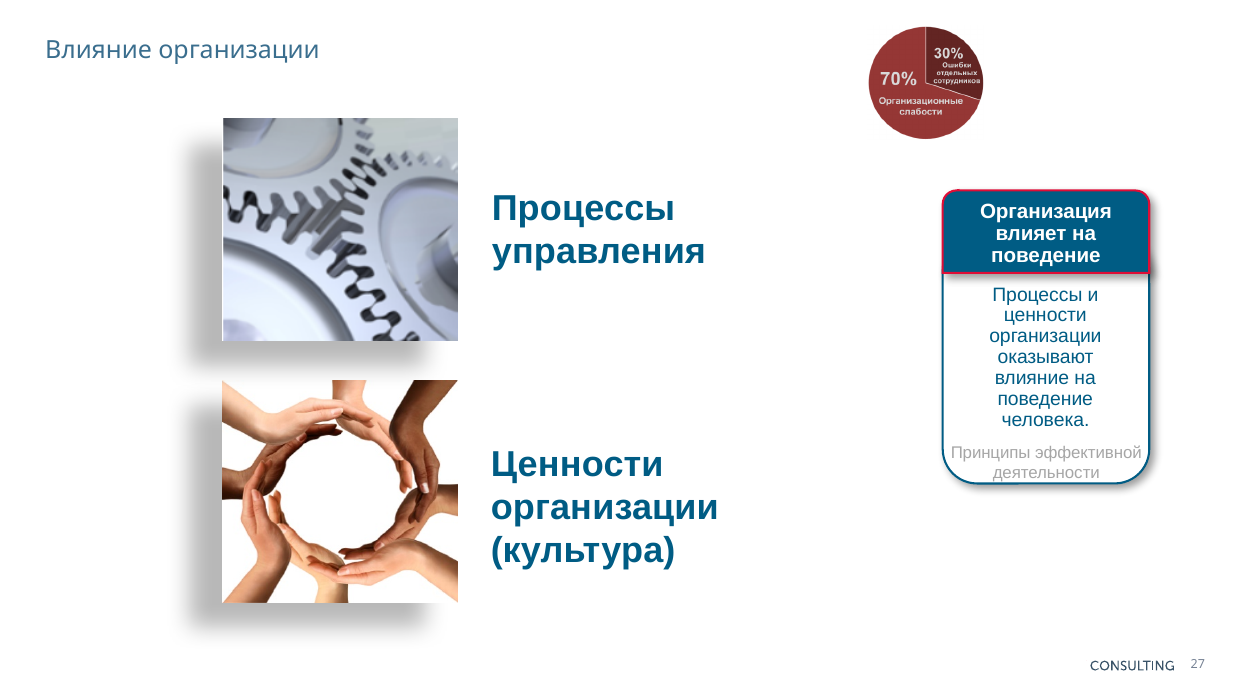
In the pie chart, what share is labelled "Ошибки отдельных сотрудников"? 30% What is the title of the slide containing the pie chart? Влияние организации What is the difference in percentage points between the "Организационные слабости" slice and the "Ошибки отдельных сотрудников" slice? 40 How many slices does the pie chart have? 2 What kind of chart is shown in the top right corner of the slide? Pie chart Which slice of the pie chart is the smallest? Ошибки отдельных сотрудников Which slice of the pie chart is the largest? Организационные слабости In the pie chart, what share is labelled "Организационные слабости"? 70% What is the combined share of the two slices in the pie chart? 100% Which is larger in the pie chart: "Организационные слабости" or "Ошибки отдельных сотрудников"? Организационные слабости